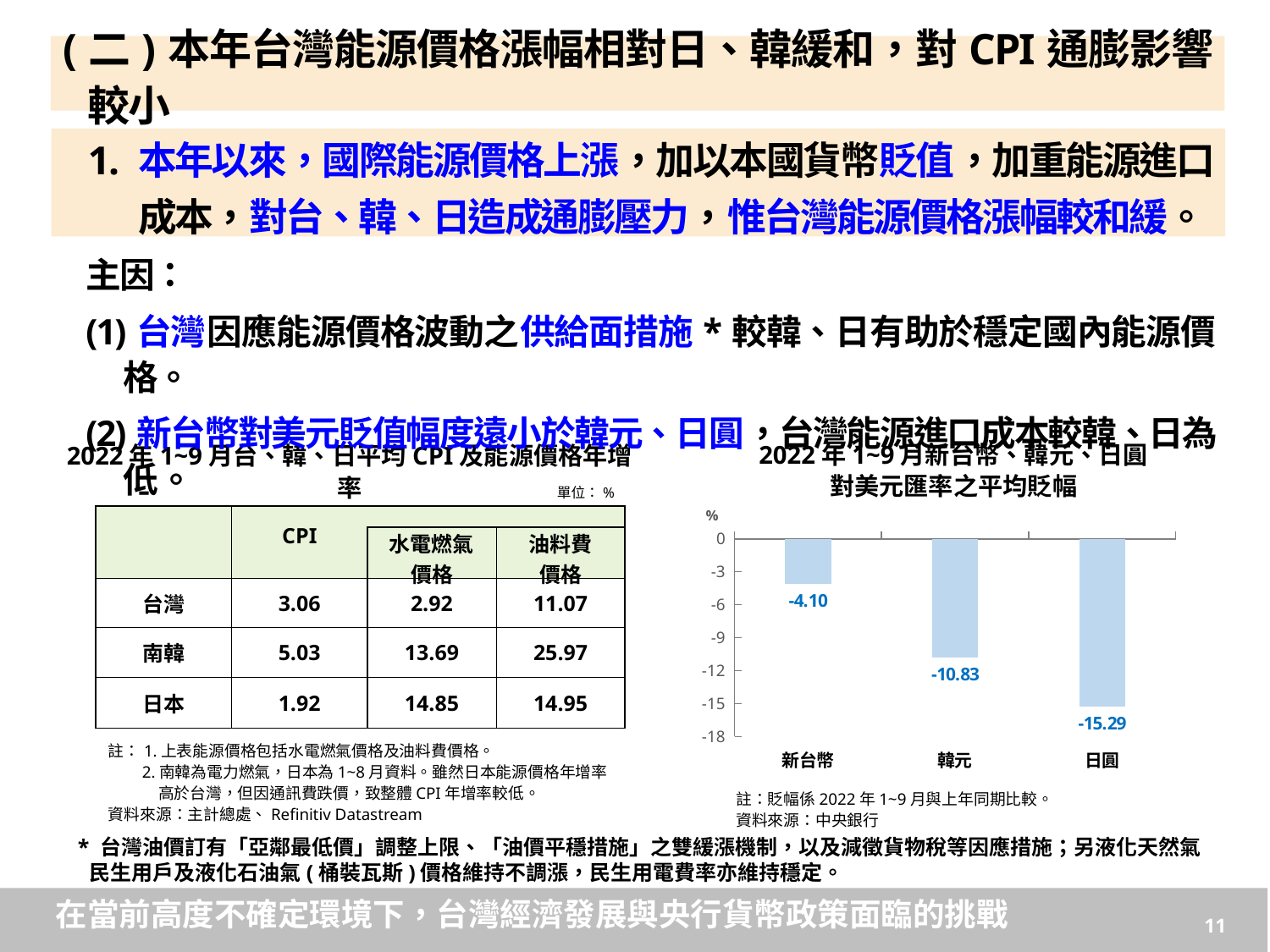
In the bar chart on the right, what is the difference between the depreciation of 韓元 and 新台幣? 6.73 In the bar chart on the right, which depreciated more against the US dollar, 韓元 or 新台幣? 韓元 In the bar chart on the right, how many currencies are plotted? 3 In the bar chart on the right, which currency shows the smallest depreciation against the US dollar? 新台幣 In the bar chart on the right, what is the difference between the depreciation of 日圓 and 韓元? 4.46 What unit is shown on the vertical axis of the bar chart on the right? % What type of chart is shown on the right side of the slide? bar chart In the bar chart on the right, what is the value for 日圓? -15.29 In the bar chart on the right, which currency shows the largest depreciation against the US dollar? 日圓 In the bar chart on the right, do the bars get longer or shorter moving from left to right along the x axis? longer In the bar chart on the right, what is the value for 新台幣? -4.10 In the bar chart on the right, what is the value for 韓元? -10.83